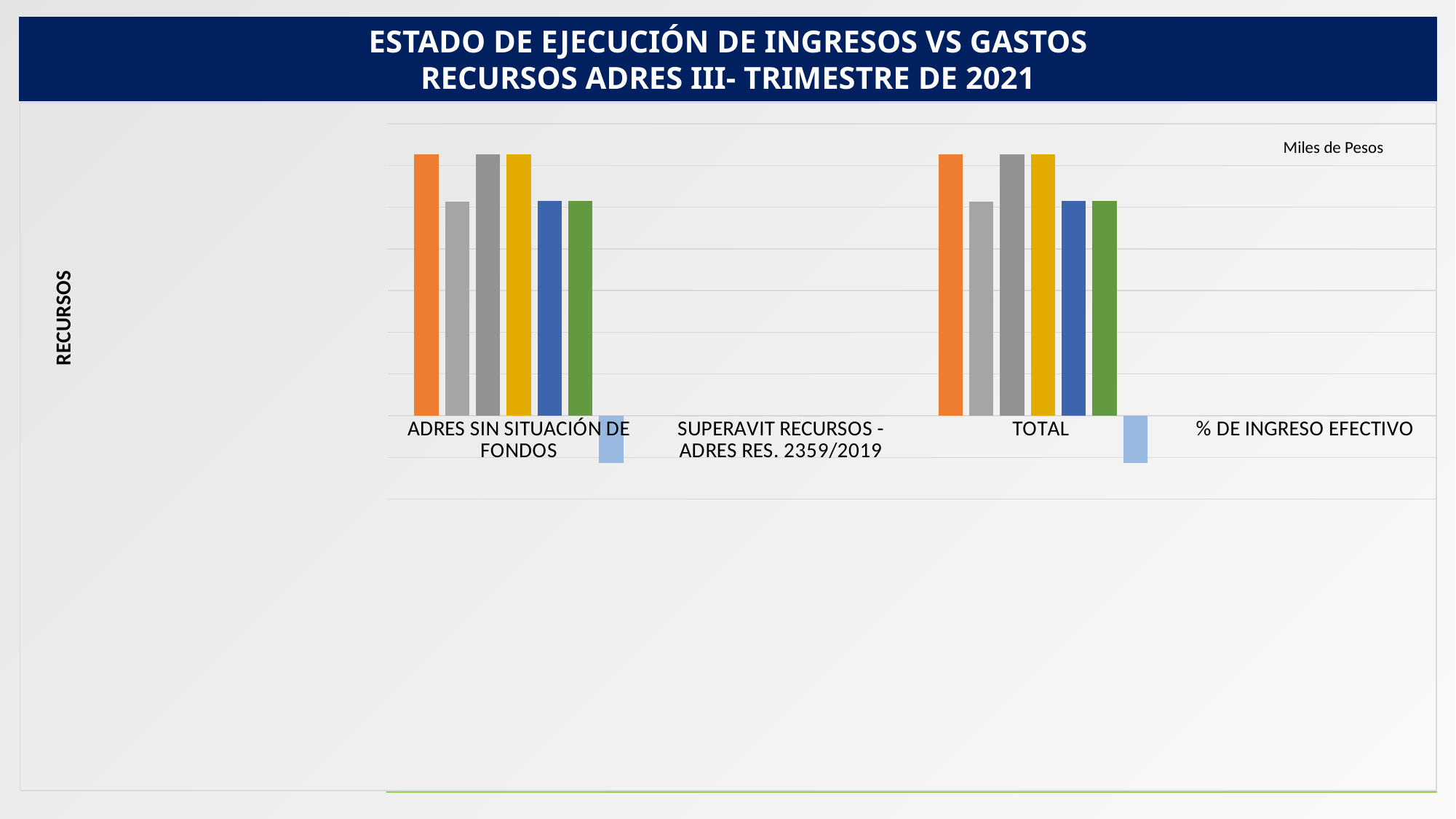
Which category shows taller bars, TOTAL or % DE INGRESO EFECTIVO? TOTAL What label is written along the vertical axis of the chart? RECURSOS What is the title shown above the chart? ESTADO DE EJECUCIÓN DE INGRESOS VS GASTOS RECURSOS ADRES III- TRIMESTRE DE 2021 What kind of chart is shown on the slide? Bar chart How many categories are labelled on the x axis of the chart? 4 Which category shows taller bars, ADRES SIN SITUACIÓN DE FONDOS or SUPERAVIT RECURSOS - ADRES RES. 2359/2019? ADRES SIN SITUACIÓN DE FONDOS